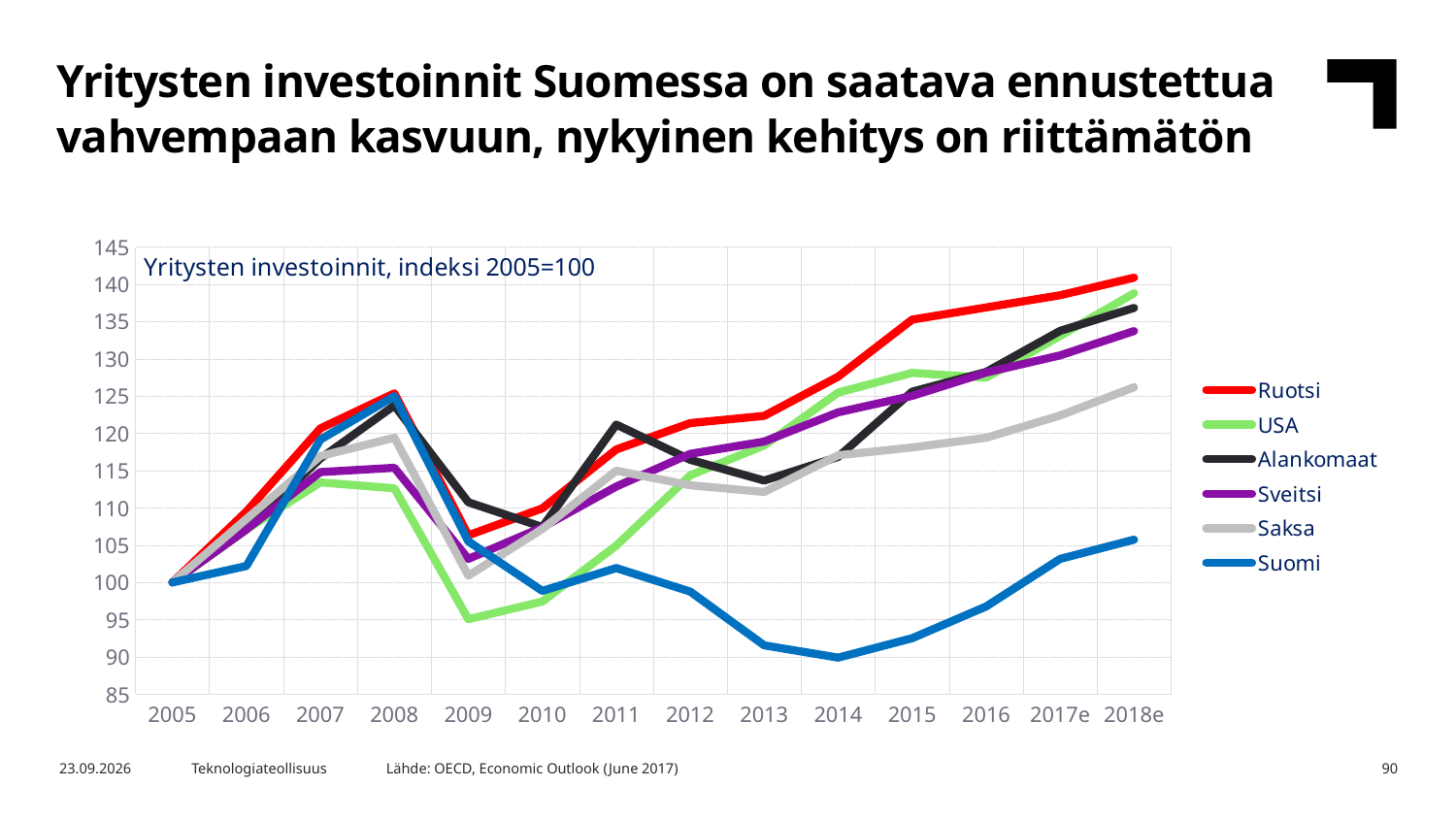
What is the index value for Suomi in 2005? 100 Is the value for Ruotsi in 2018e greater or less than 135? greater In 2009, which is larger: the value for USA or the value for Suomi? Suomi Which series has the lowest value in 2018e? Suomi What is the title shown inside the chart area? Yritysten investoinnit, indeksi 2005=100 Is the value for Suomi in 2014 greater or less than 95? less How many series does the legend list? 6 Which series has the highest value in 2018e? Ruotsi Is the value for USA in 2009 greater or less than 100? less What kind of chart is shown on the slide? line chart How many years are shown along the x axis? 14 Does the Suomi line rise or fall from 2011 to 2014? fall